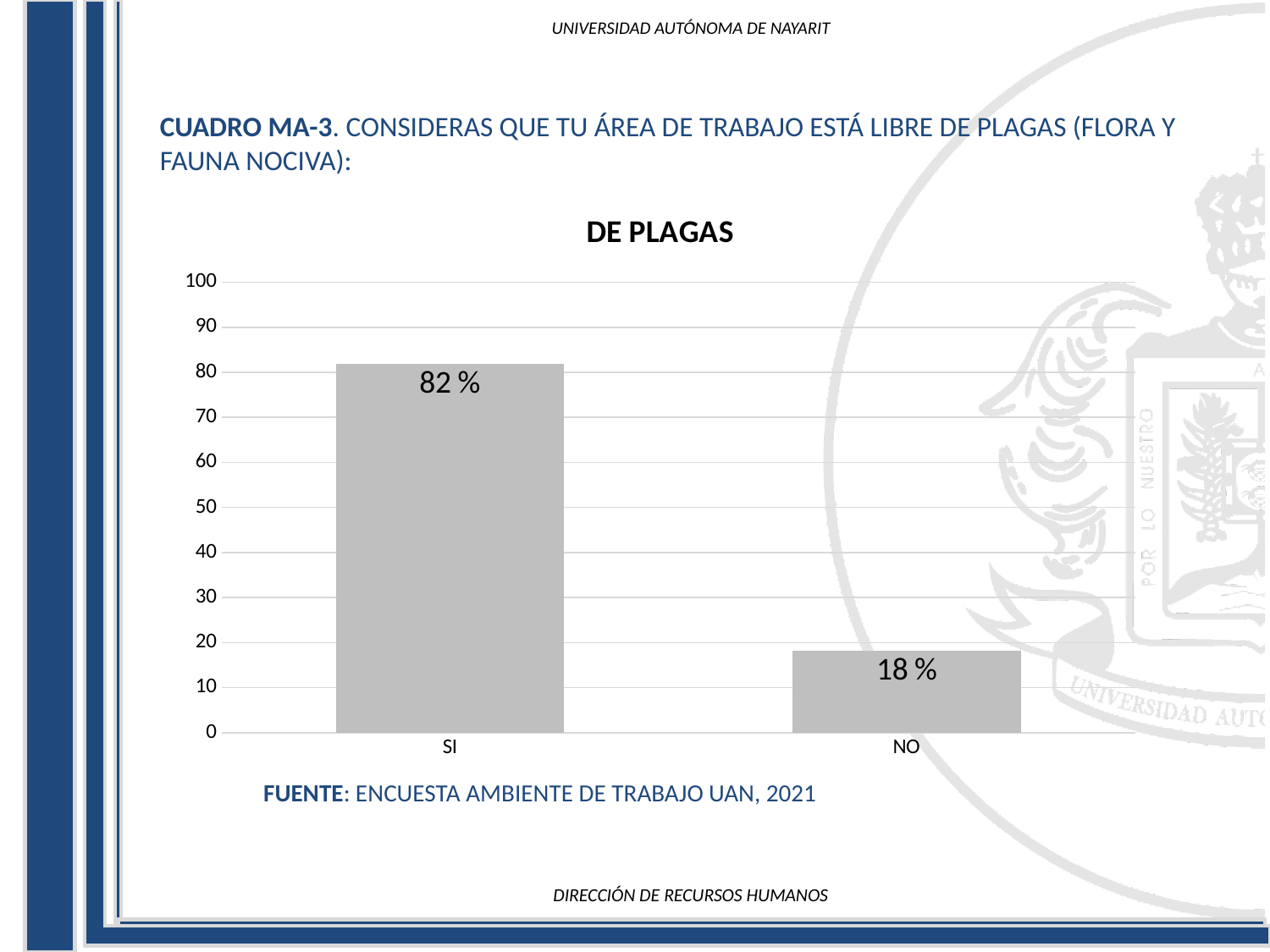
How many categories are shown on the x axis? 2 Which is larger, the value for SI or the value for NO? SI What is the value for SI? 82 % What is the title of the chart? DE PLAGAS What is the highest value shown on the y axis? 100 Is the value for NO greater or less than 20? less Which category has the highest value? SI What is the value for NO? 18 % Is the value for SI greater or less than 80? greater What is the difference between the values for SI and NO? 64 % Which category has the lowest value? NO What kind of chart is shown? bar chart